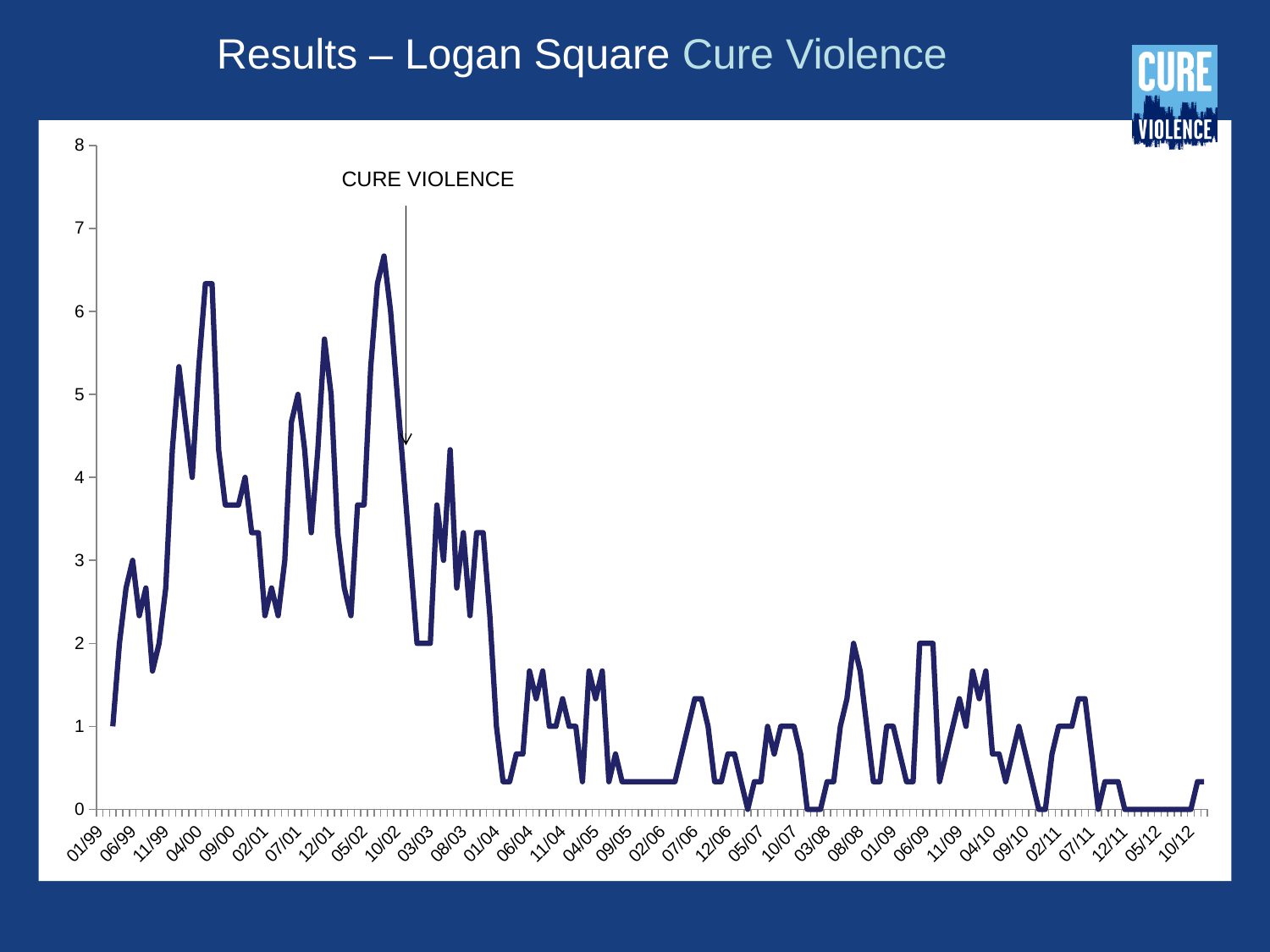
Is the peak of the line near 04/00 greater or less than 6? greater Is the value of the line at 08/08 greater or less than 3? less What is the title of the slide containing the chart? Results – Logan Square Cure Violence Overall, do the values of the line rise or fall from the period before 01/04 to the period after 01/04? fall What is the maximum value shown on the y axis? 8 Is the highest peak of the line, near 10/02, greater or less than 6? greater What is the first date label on the x axis? 01/99 What label is attached to the arrow annotation on the chart? CURE VIOLENCE What is the last date label on the x axis? 10/12 What kind of chart is shown on the slide? line chart